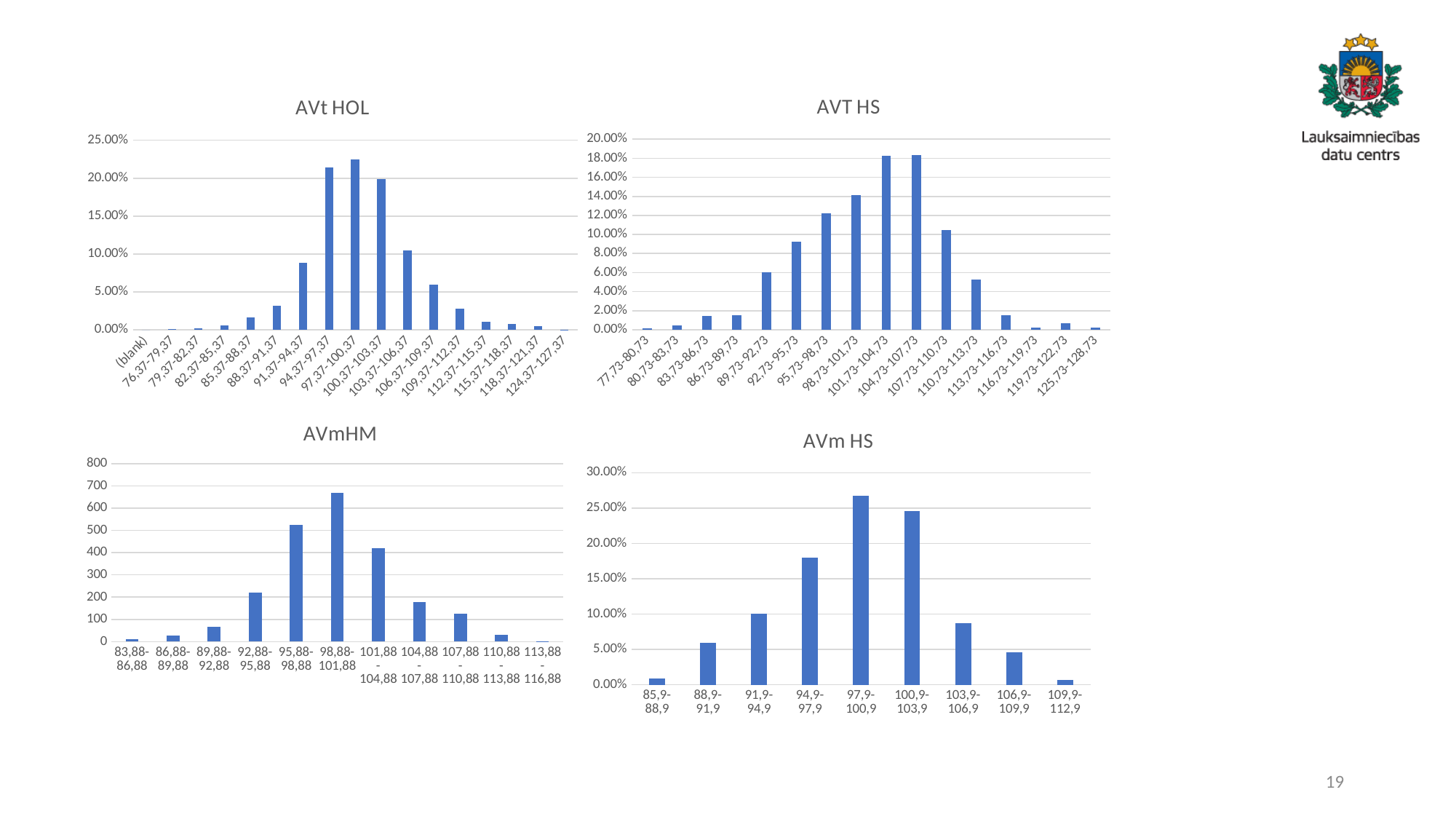
In the AVm HS chart, how many categories are shown on the x axis? 9 In the AVmHM chart, is the value for 95,88-98,88 greater or less than 500? greater In the AVt HOL chart, is the value for 94,37-97,37 greater or less than 20.00%? greater In the AVm HS chart, which category has the highest value? 97,9-100,9 How many charts are shown on the slide? 4 In the AVT HS chart, is the value for 110,73-113,73 greater or less than 4.00%? greater In the AVm HS chart, which is larger, the value for 88,9-91,9 or the value for 106,9-109,9? 88,9-91,9 In the AVmHM chart, which is larger, the value for 95,88-98,88 or the value for 101,88-104,88? 95,88-98,88 In the AVmHM chart, which category has the highest value? 98,88-101,88 What kind of chart is the AVm HS chart? bar chart